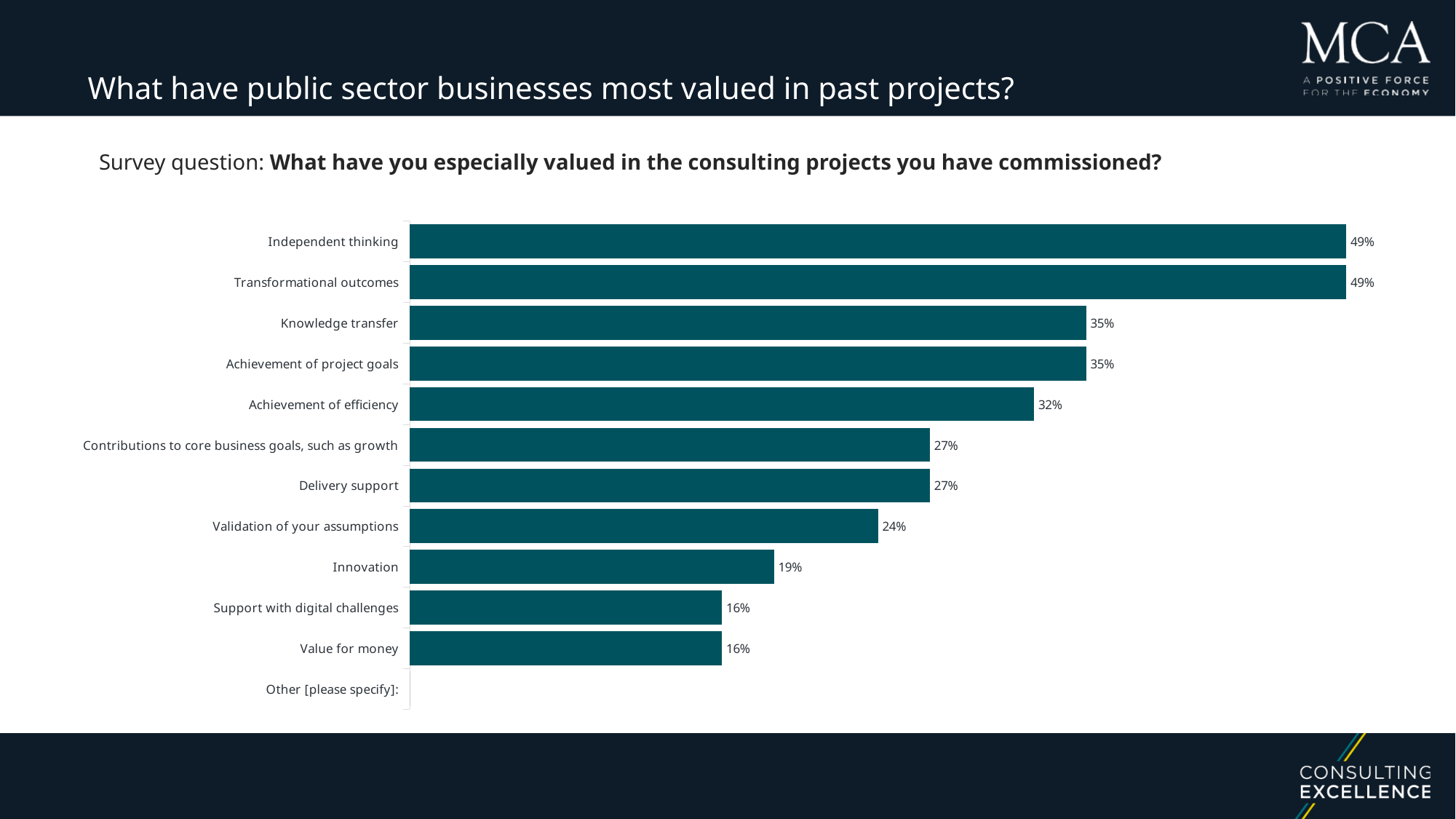
What is the value for Achievement of efficiency? 32% What kind of chart is shown on the slide? bar chart Which is larger, the value for Achievement of efficiency or the value for Delivery support? Achievement of efficiency What is the value for Value for money? 16% What is the difference between the values for Delivery support and Innovation? 8% What is the value for Validation of your assumptions? 24% What is the difference between the values for Independent thinking and Knowledge transfer? 14% What is the value for Innovation? 19% What is the highest value shown in the chart? 49% Which category on the chart has no bar plotted? Other [please specify]: What is the value for Knowledge transfer? 35% How many categories are listed on the vertical axis of the chart? 12